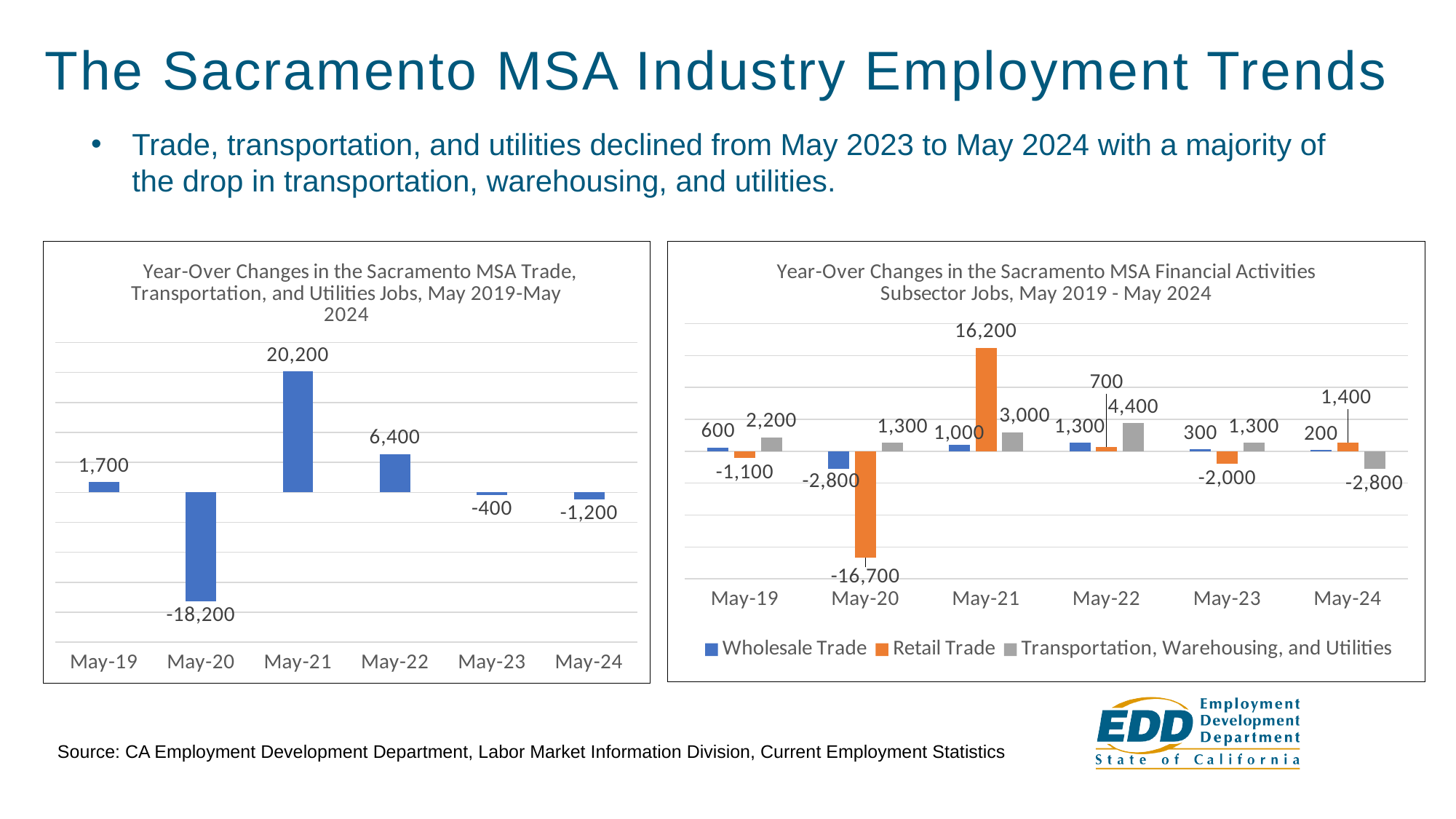
In the right chart (Financial Activities Subsector Jobs), what is the Transportation, Warehousing, and Utilities value for May-22? 4,400 In the right chart (Financial Activities Subsector Jobs), which series has the highest value in May-21? Retail Trade What type of chart is the left chart (Trade, Transportation, and Utilities Jobs)? Bar chart In the left chart (Trade, Transportation, and Utilities Jobs), how many months are plotted? 6 In the left chart (Trade, Transportation, and Utilities Jobs), what is the year-over change for May-20? -18,200 In the left chart (Trade, Transportation, and Utilities Jobs), what is the year-over change for May-21? 20,200 In the right chart (Financial Activities Subsector Jobs), what colour represents Retail Trade? Orange In the right chart (Financial Activities Subsector Jobs), is the Wholesale Trade value for May-22 larger or smaller than the Retail Trade value for May-22? Larger In the right chart (Financial Activities Subsector Jobs), what is the Retail Trade value for May-20? -16,700 In the left chart (Trade, Transportation, and Utilities Jobs), what is the difference between the May-21 and May-22 values? 13,800 In the right chart (Financial Activities Subsector Jobs), how many series does the legend list? 3 In the left chart (Trade, Transportation, and Utilities Jobs), which month has the lowest value? May-20